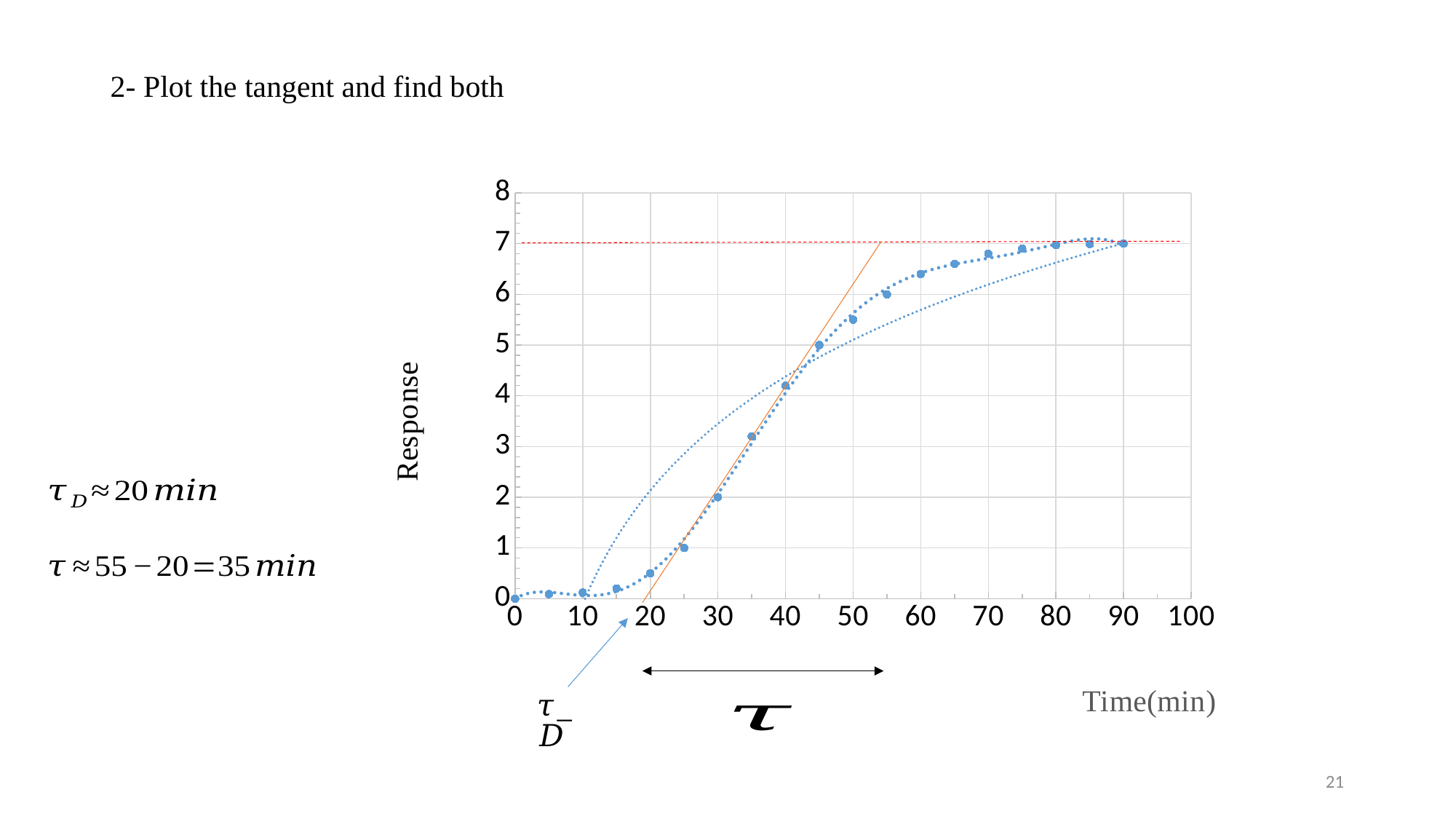
Which has the larger Response value, 30 min or 50 min? 50 min What is the Response value at 25 min? 1 Is the Response value at 70 min greater or less than 6? greater Is the Response value at 40 min greater or less than 4? greater What is the label of the horizontal axis? Time(min) Is the Response value at 20 min greater or less than 1? less What is the Response value at 30 min? 2 What is the Response value at 45 min? 5 What kind of chart is shown on the slide? scatter chart Does the Response rise or fall as Time increases from 0 to 90 min? rise What is the Response value at 90 min? 7 What is the label of the vertical axis? Response